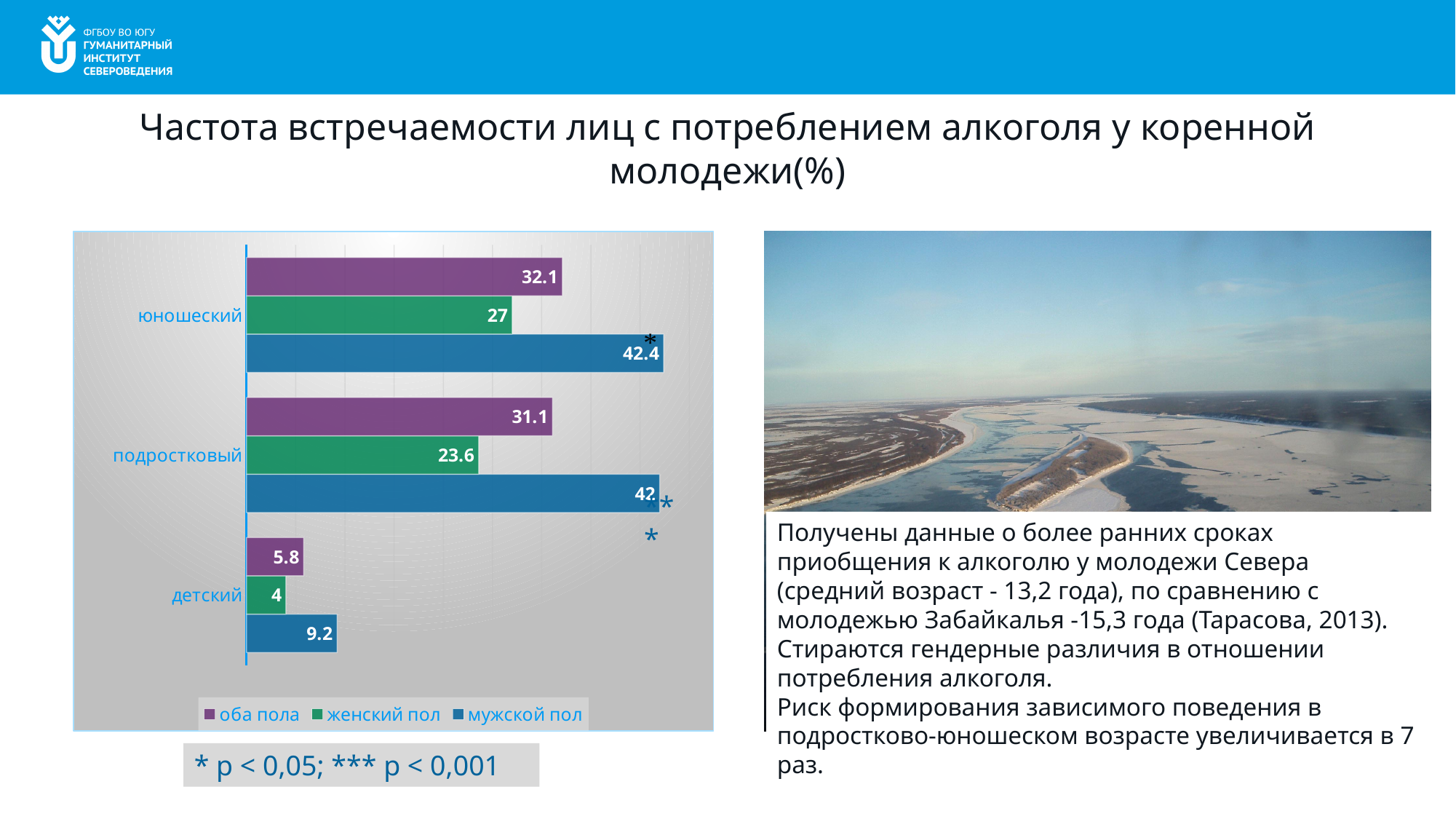
What is the value for оба пола in the подростковый category? 31.1 How many series does the legend list? 3 What is the value for женский пол in the детский category? 4 What is the difference between the мужской пол and оба пола values in the детский category? 3.4 What is the difference between the мужской пол and женский пол values in the юношеский category? 15.4 How many age categories are shown on the chart? 3 What is the value for женский пол in the юношеский category? 27 Which category has the highest value for женский пол? юношеский Which is larger: the оба пола value for юношеский or for подростковый? юношеский What is the value for мужской пол in the юношеский category? 42.4 Which category has the lowest value for мужской пол? детский What kind of chart is shown on the slide? bar chart